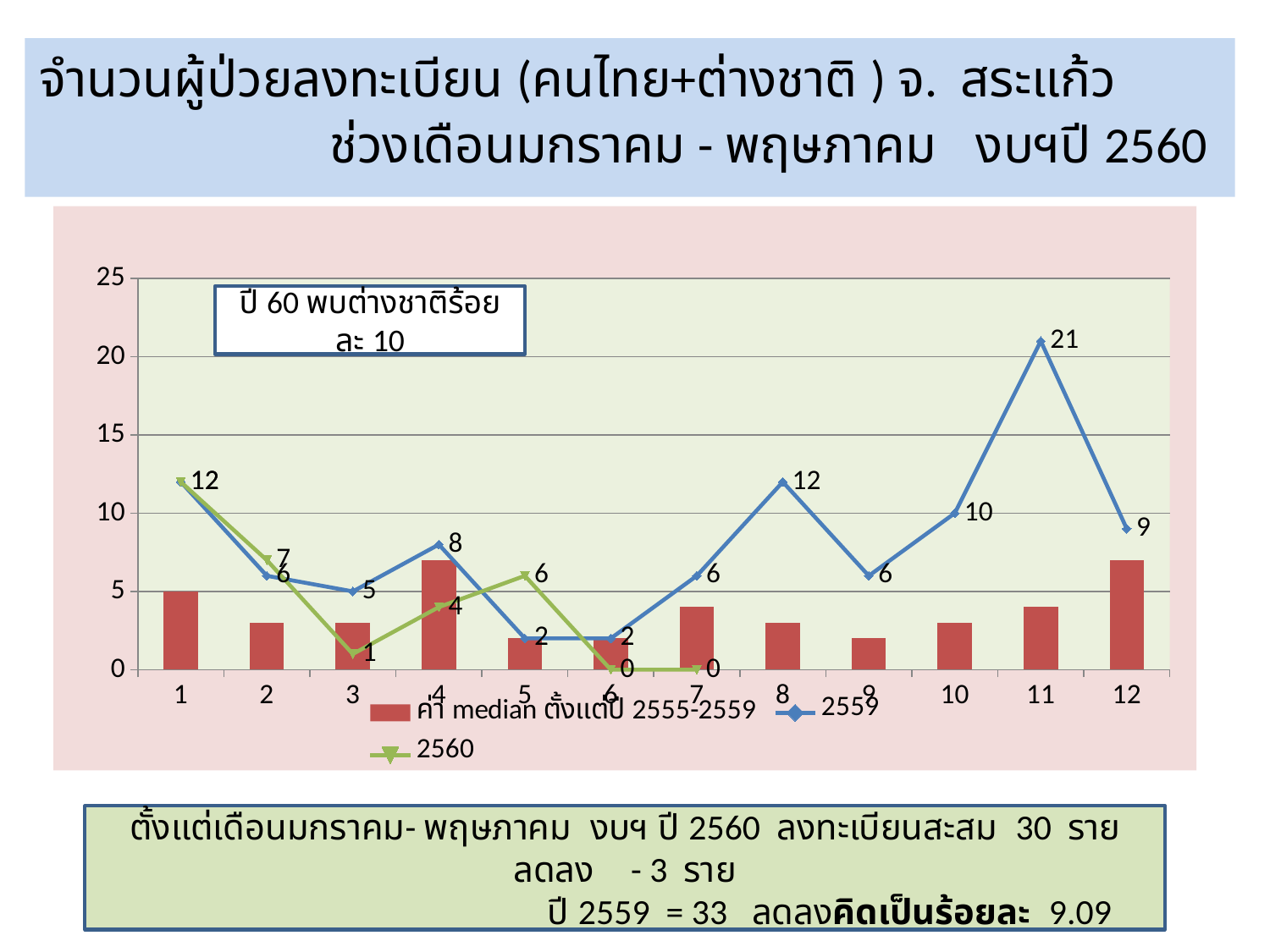
How many months (categories) are shown on the x axis? 12 How many series does the legend list? 3 What is the value of the 2559 series at month 11? 21 What is the difference between the 2559 values at month 8 and month 9? 6 At month 2, which series has the larger value, 2559 or 2560? 2560 Is the median bar (ค่า median ตั้งแต่ปี 2555-2559) at month 5 greater or less than 5? less What is the value of the 2559 series at month 12? 9 What is the value of the 2560 series at month 5? 6 What is the lowest value shown for the 2560 series? 0 At which month does the 2559 series reach its highest value? 11 Is the median bar (ค่า median ตั้งแต่ปี 2555-2559) at month 4 greater or less than 5? greater What kind of chart is this? Combined bar and line chart